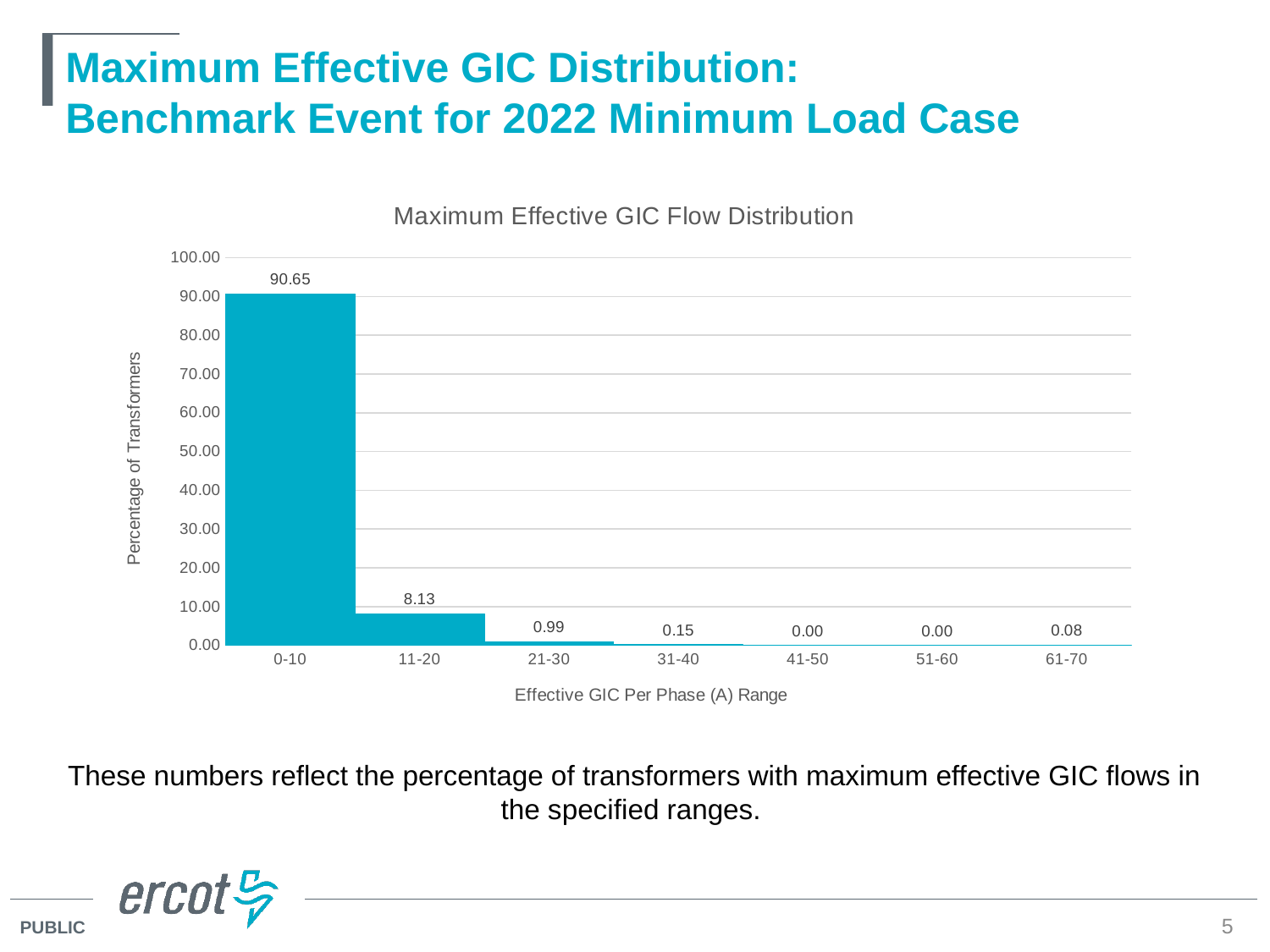
What is the value for the 61-70 range? 0.08 What is the title of the chart? Maximum Effective GIC Flow Distribution What kind of chart is shown? Bar chart Which is larger, the value for 31-40 or the value for 61-70? 31-40 What is the value for the 21-30 range? 0.99 What is the percentage of transformers in the 0-10 range? 90.65 What is the difference between the values for the 0-10 and 11-20 ranges? 82.52 What is the percentage of transformers in the 11-20 range? 8.13 Which range has the highest percentage of transformers? 0-10 How many ranges are shown on the x axis? 7 Do the values generally rise or fall from left to right along the x axis? Fall Is the value for the 0-10 range greater or less than 90? greater